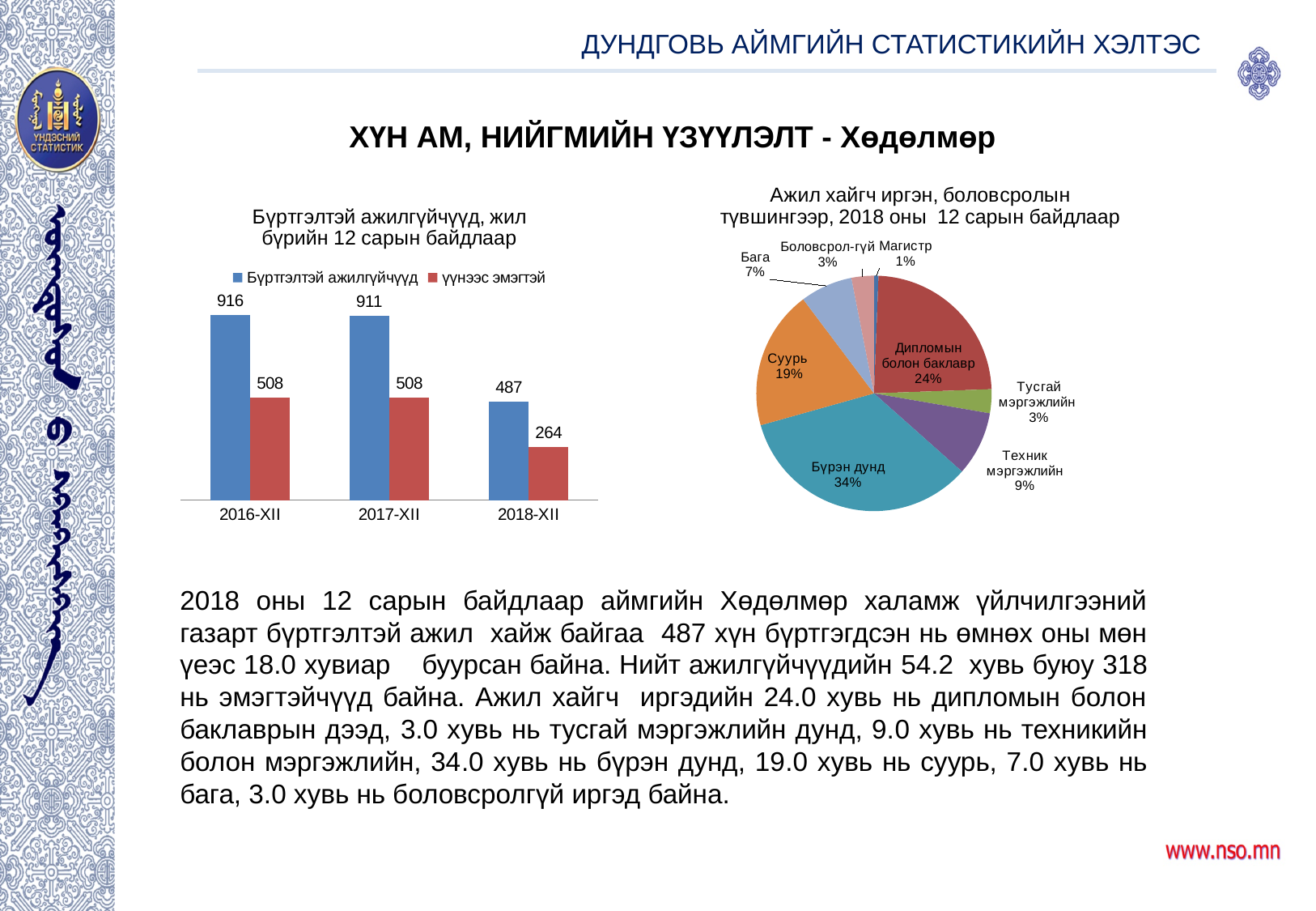
In the bar chart on the left, what is the value of үүнээс эмэгтэй for 2017-XII? 508 In the bar chart on the left, which year has the lowest value for үүнээс эмэгтэй? 2018-XII In the bar chart on the left, what is the value of Бүртгэлтэй ажилгүйчүүд for 2018-XII? 487 In the pie chart on the right, which is larger: Суурь or Техник мэргэжлийн? Суурь In the bar chart on the left, does the value of Бүртгэлтэй ажилгүйчүүд rise or fall from 2016-XII to 2018-XII? fall What kind of chart is the chart on the right? pie chart In the bar chart on the left, how many series does the legend list? 2 In the pie chart on the right, what share does Бүрэн дунд have? 34% In the pie chart on the right, how many categories are shown? 8 In the pie chart on the right, which category has the smallest share? Магистр In the bar chart on the left, what is the difference between Бүртгэлтэй ажилгүйчүүд and үүнээс эмэгтэй for 2016-XII? 408 In the bar chart on the left, which year has the highest value for Бүртгэлтэй ажилгүйчүүд? 2016-XII